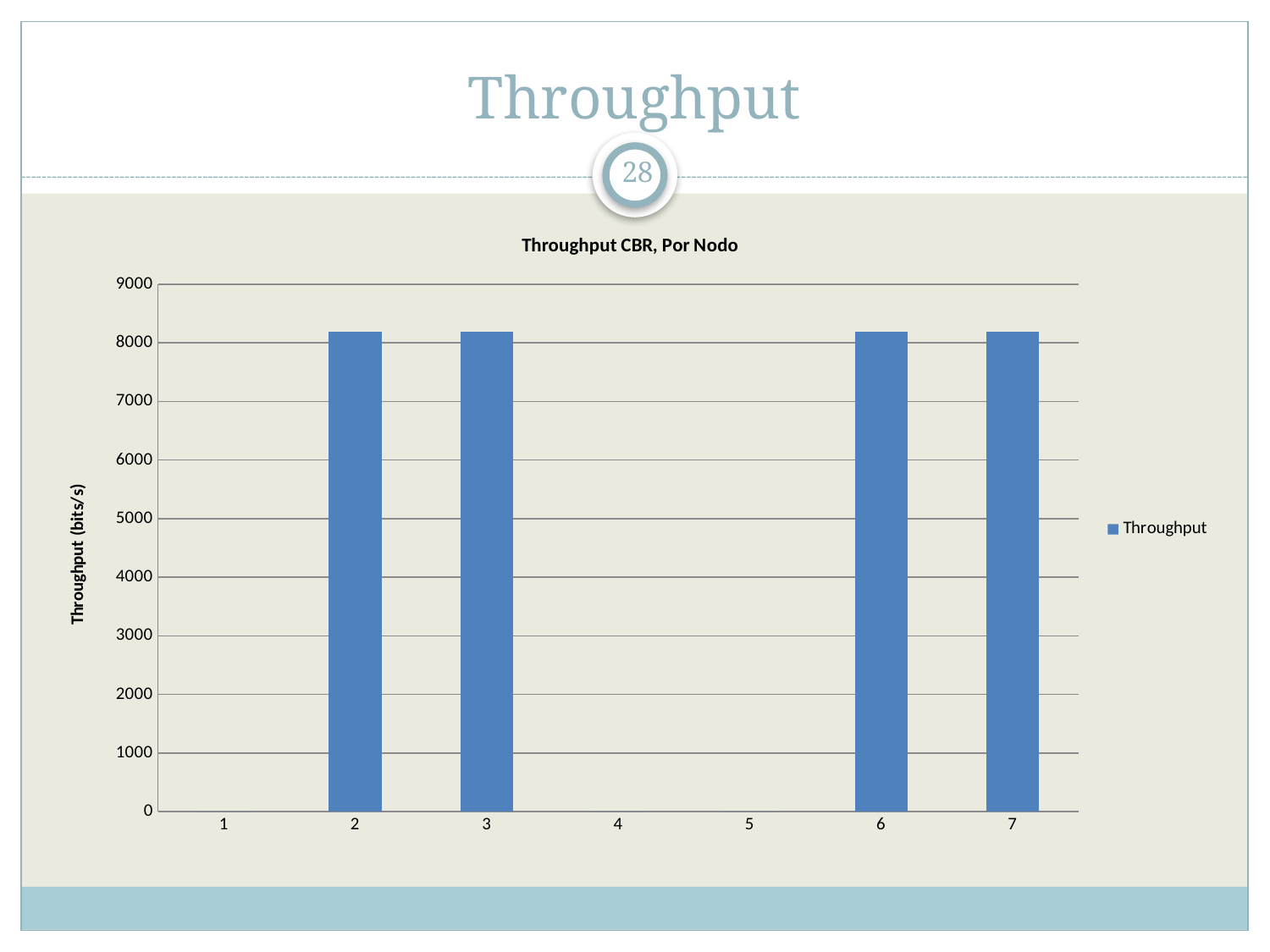
Which is larger, the value for node 4 or the value for node 7? node 7 Which is larger, the value for node 2 or the value for node 1? node 2 Is the value for node 7 greater or less than 8000? greater What kind of chart is shown on the slide? bar chart How many node categories are shown on the x axis? 7 How many nodes have a visible bar in the chart? 4 Is the value for node 6 greater or less than 9000? less Is the value for node 2 greater or less than 7000? greater How many series does the legend list? 1 What is the title of the chart? Throughput CBR, Por Nodo What is the label of the y axis? Throughput (bits/s)